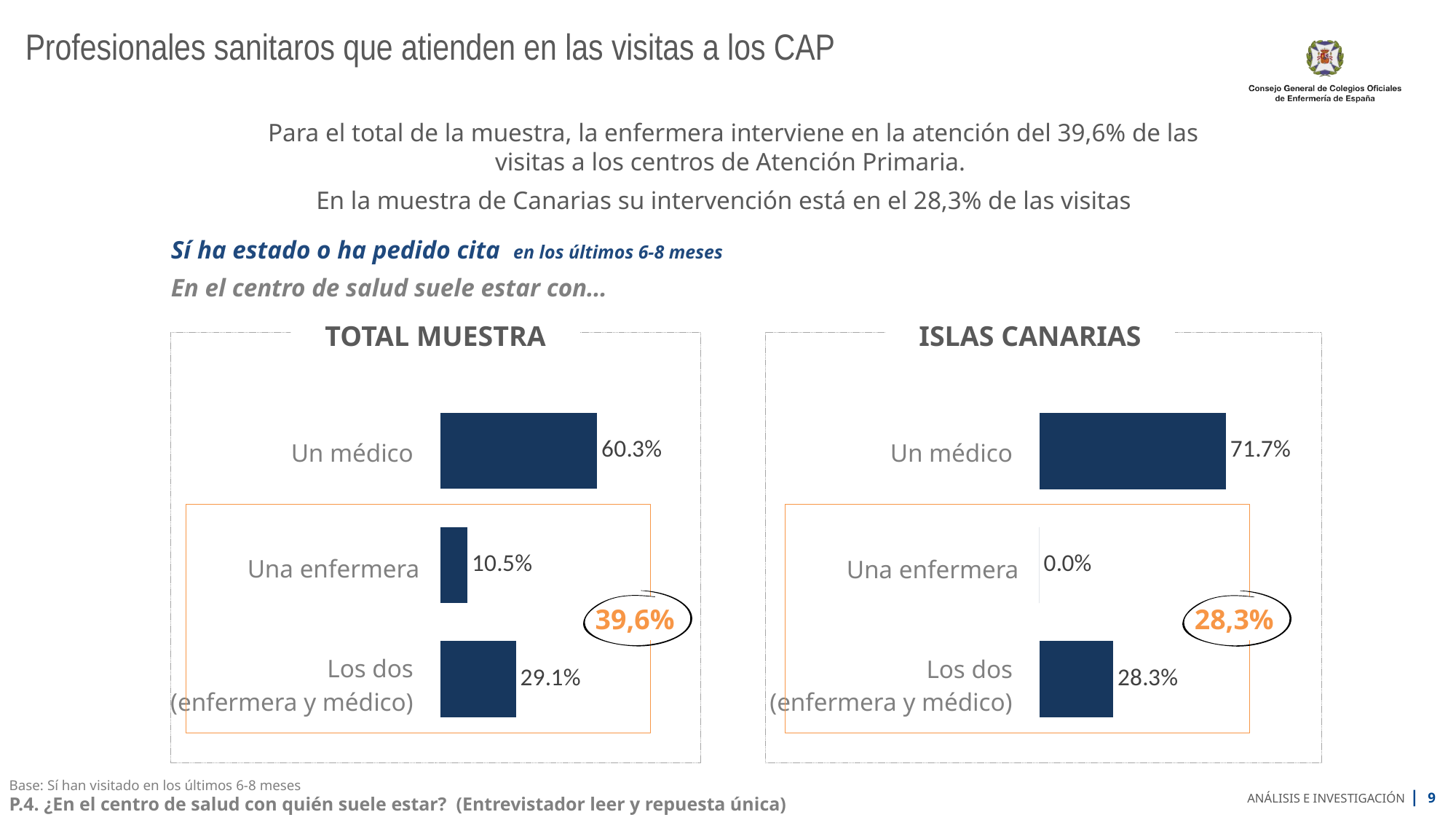
In the ISLAS CANARIAS chart, what is the value for Los dos (enfermera y médico)? 28.3% In the ISLAS CANARIAS chart, which category has the highest value? Un médico In the ISLAS CANARIAS chart, what is the value for Una enfermera? 0.0% In the TOTAL MUESTRA chart, what is the value for Un médico? 60.3% In the TOTAL MUESTRA chart, what is the value for Una enfermera? 10.5% Which chart has the larger value for Un médico, TOTAL MUESTRA or ISLAS CANARIAS? ISLAS CANARIAS In the ISLAS CANARIAS chart, what is the difference between Un médico and Los dos (enfermera y médico)? 43.4% In the TOTAL MUESTRA chart, which category has the lowest value? Una enfermera What type of chart is the ISLAS CANARIAS chart? Bar chart How many categories does the TOTAL MUESTRA chart show? 3 What is the title of the chart on the left side of the slide? TOTAL MUESTRA In the TOTAL MUESTRA chart, what is the difference between Un médico and Los dos (enfermera y médico)? 31.2%